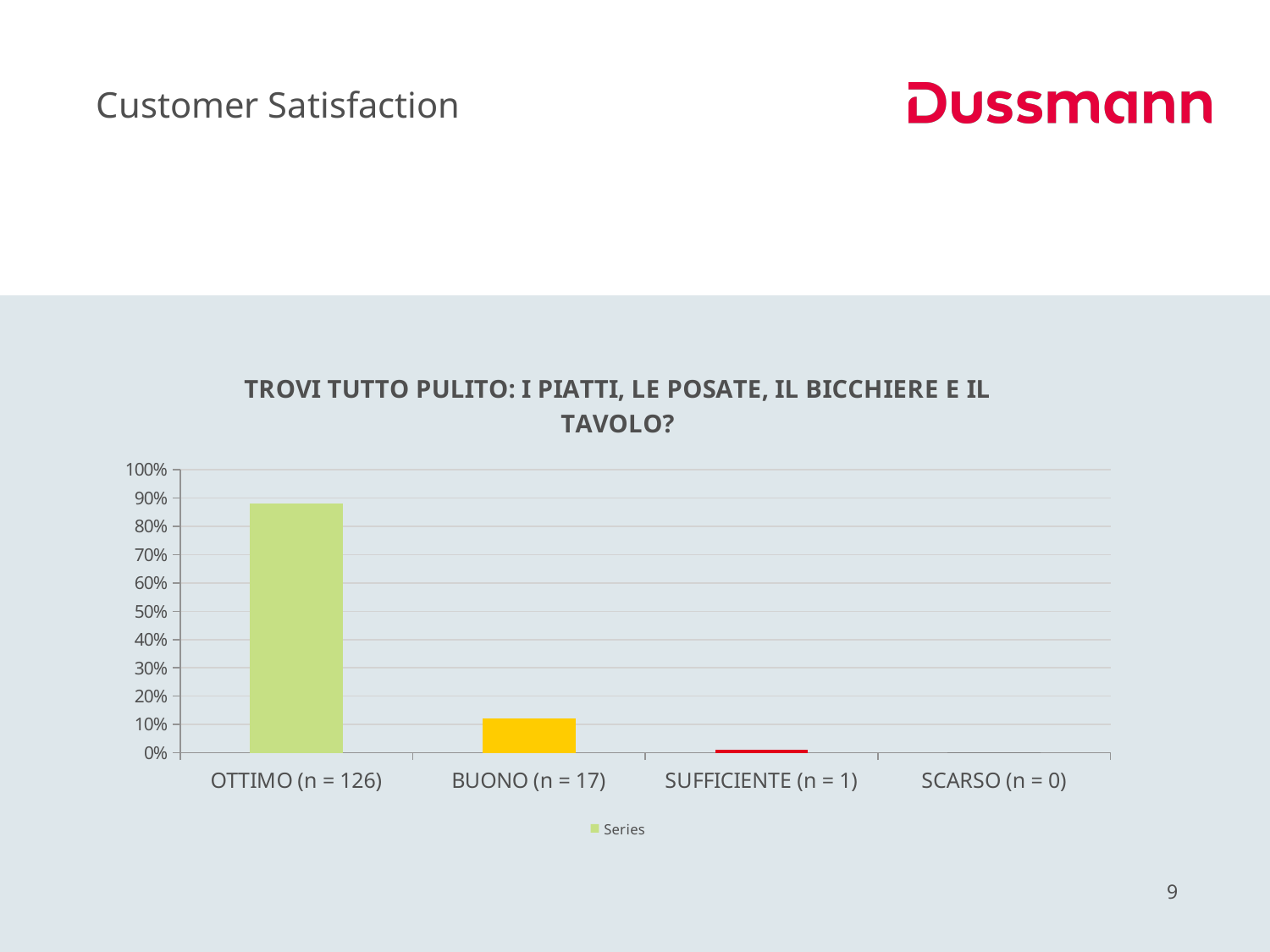
What colour is the bar for OTTIMO (n = 126)? green Is the value for SUFFICIENTE (n = 1) greater or less than 10%? less Is the value for OTTIMO (n = 126) greater or less than 80%? greater Which is larger, the value for OTTIMO (n = 126) or the value for BUONO (n = 17)? OTTIMO (n = 126) How many series does the chart legend list? 1 How many categories are shown on the x axis of the chart? 4 What is the title of the chart? TROVI TUTTO PULITO: I PIATTI, LE POSATE, IL BICCHIERE E IL TAVOLO? Is the value for BUONO (n = 17) greater or less than 20%? less Do the values rise or fall moving from left to right along the x axis? fall Which category has the lowest value in the chart? SCARSO (n = 0) Which category has the highest value in the chart? OTTIMO (n = 126) What kind of chart is shown on the slide? bar chart